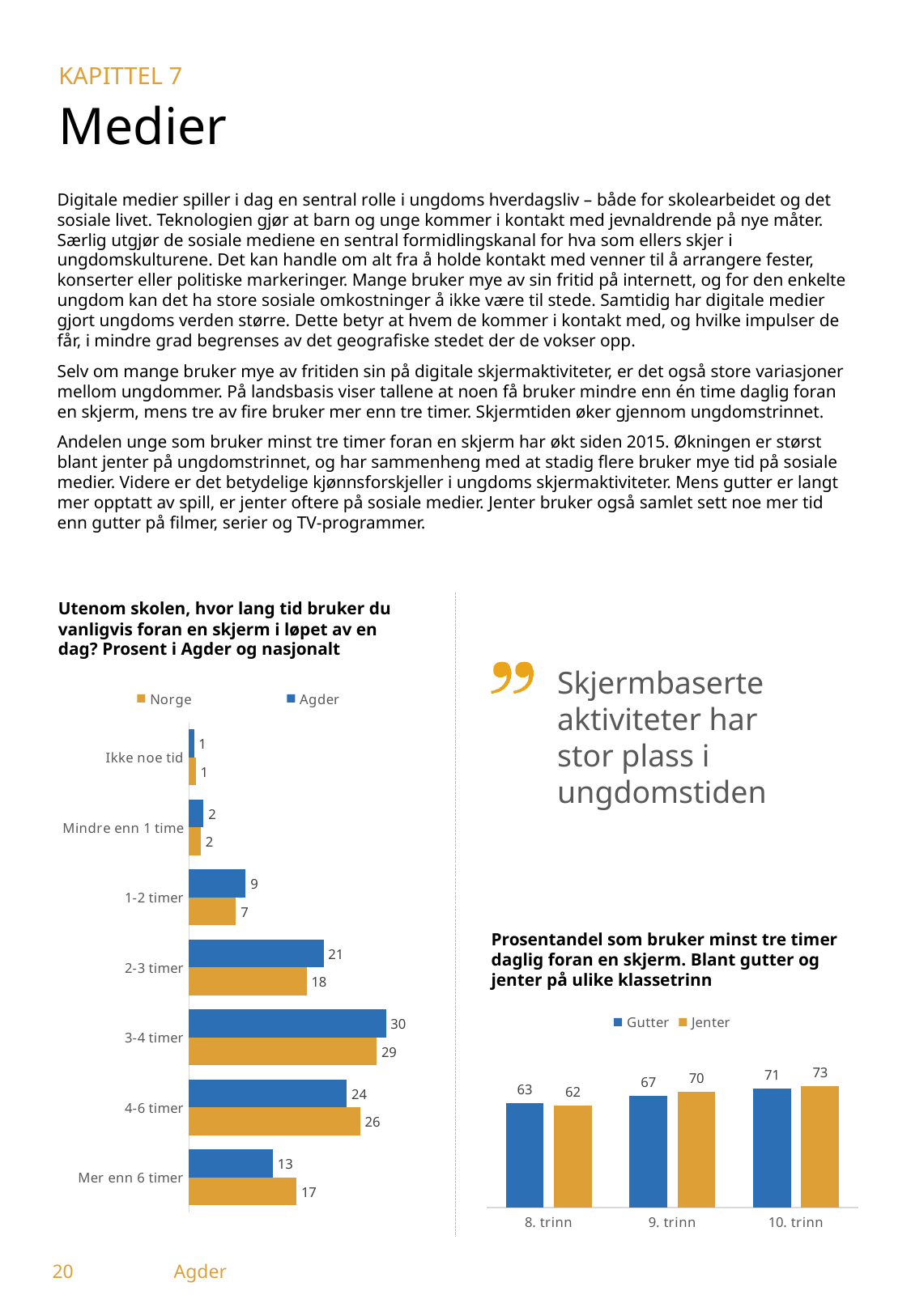
In the left chart (Utenom skolen, hvor lang tid bruker du vanligvis foran en skjerm), how many categories are shown? 7 In the right chart (Prosentandel som bruker minst tre timer daglig foran en skjerm), what is the Jenter value for 9. trinn? 70 In the left chart (Utenom skolen, hvor lang tid bruker du vanligvis foran en skjerm), which is larger for 4-6 timer, Norge or Agder? Norge In the left chart (Utenom skolen, hvor lang tid bruker du vanligvis foran en skjerm), what is the Agder value for 2-3 timer? 21 In the right chart (Prosentandel som bruker minst tre timer daglig foran en skjerm), what is the difference between Jenter and Gutter for 10. trinn? 2 What kind of chart is the left chart (Utenom skolen, hvor lang tid bruker du vanligvis foran en skjerm)? Bar chart In the left chart (Utenom skolen, hvor lang tid bruker du vanligvis foran en skjerm), what is the difference between the Agder and Norge values for 1-2 timer? 2 In the right chart (Prosentandel som bruker minst tre timer daglig foran en skjerm), which class level has the highest Gutter value? 10. trinn In the left chart (Utenom skolen, hvor lang tid bruker du vanligvis foran en skjerm), what is the Norge value for Mer enn 6 timer? 17 In the right chart (Prosentandel som bruker minst tre timer daglig foran en skjerm), do the Jenter values rise or fall from 8. trinn to 10. trinn? Rise In the left chart (Utenom skolen, hvor lang tid bruker du vanligvis foran en skjerm), which category has the highest Agder value? 3-4 timer In the left chart (Utenom skolen, hvor lang tid bruker du vanligvis foran en skjerm), how many series does the legend list? 2